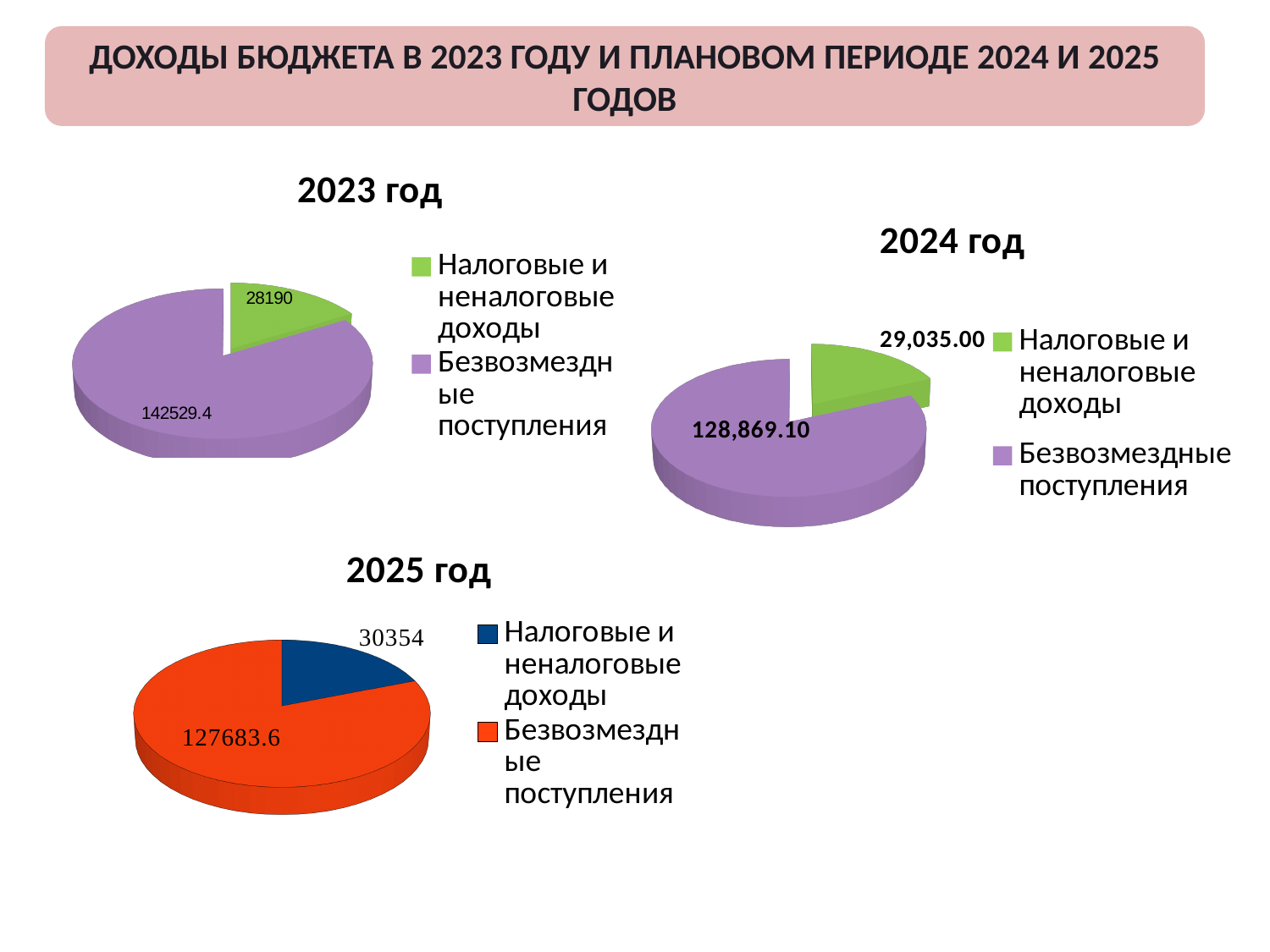
On the '2025 год' chart, which category has the largest slice? Безвозмездные поступления What type of chart is the '2024 год' chart? Pie chart On the '2025 год' chart, what is the difference between Безвозмездные поступления and Налоговые и неналоговые доходы? 97329.6 On the '2024 год' chart, what is the value for Безвозмездные поступления? 128,869.10 On the '2023 год' chart, what is the value for Безвозмездные поступления? 142529.4 On the '2023 год' chart, what is the value for Налоговые и неналоговые доходы? 28190 On the '2024 год' chart, which category has the smallest slice? Налоговые и неналоговые доходы On the '2025 год' chart, what is the value for Безвозмездные поступления? 127683.6 On the '2025 год' chart, what colour is the slice for Налоговые и неналоговые доходы? Dark blue How many categories does the '2023 год' chart show? 2 On the '2024 год' chart, what is the value for Налоговые и неналоговые доходы? 29,035.00 On the '2023 год' chart, what is the difference between Безвозмездные поступления and Налоговые и неналоговые доходы? 114339.4